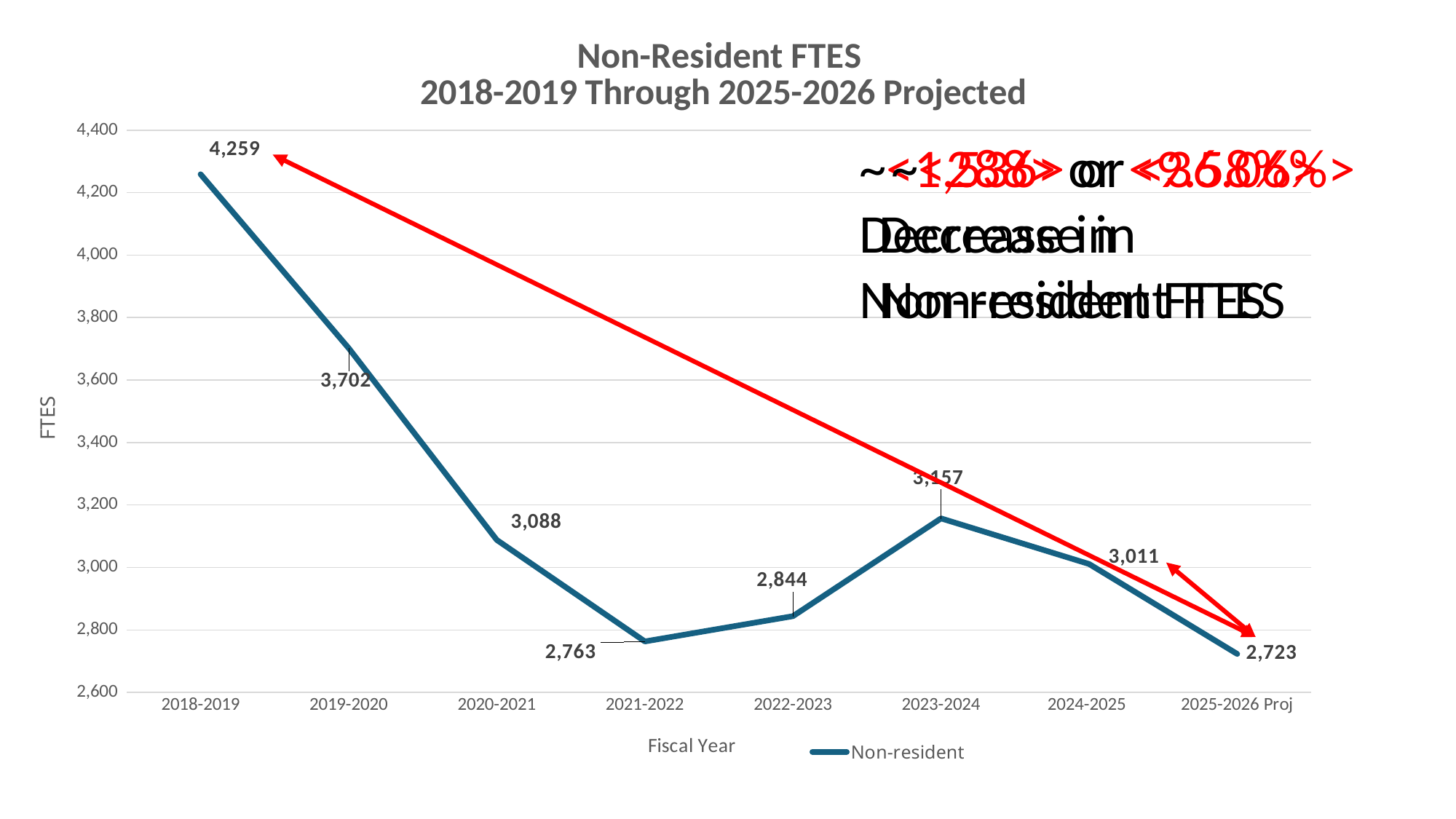
How many series does the legend list? 1 What is the Non-resident FTES value for 2018-2019? 4,259 What is the Non-resident FTES value for 2021-2022? 2,763 How many fiscal years are plotted on the x axis? 8 Which fiscal year has the lowest Non-resident FTES value? 2025-2026 Proj What is the label on the y axis of the chart? FTES What is the Non-resident FTES value for 2025-2026 Proj? 2,723 Which is larger, the Non-resident FTES value for 2023-2024 or for 2024-2025? 2023-2024 Is the Non-resident FTES value for 2019-2020 greater or less than 3,600? greater What type of chart is shown on the slide? Line chart What is the difference between the Non-resident FTES values for 2018-2019 and 2025-2026 Proj? 1,536 Which fiscal year has the highest Non-resident FTES value? 2018-2019